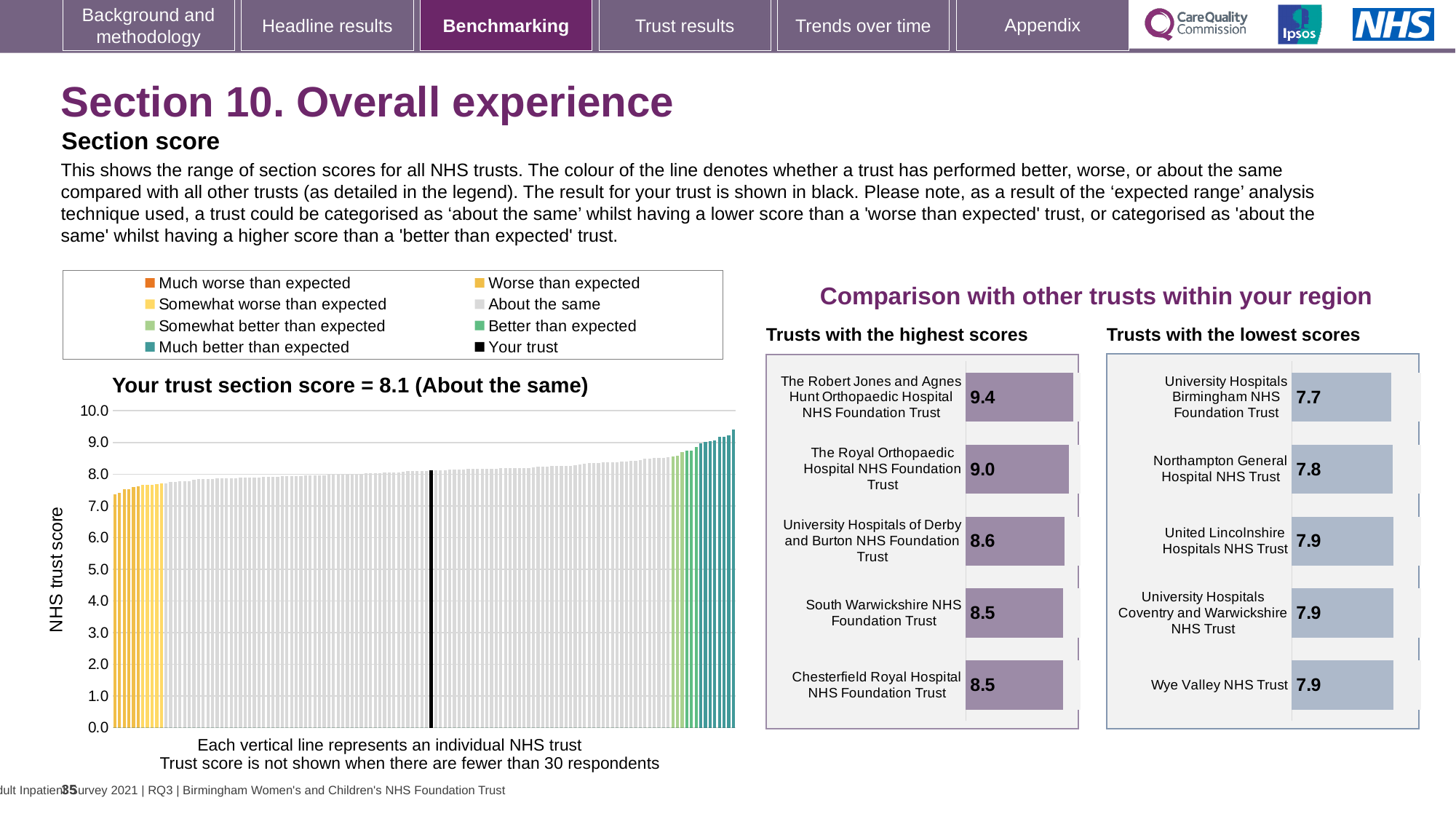
In the 'Trusts with the highest scores' chart, which has the higher score: The Royal Orthopaedic Hospital NHS Foundation Trust or Chesterfield Royal Hospital NHS Foundation Trust? The Royal Orthopaedic Hospital NHS Foundation Trust What kind of chart is the main chart on the left titled 'Your trust section score = 8.1 (About the same)'? Bar chart In the 'Trusts with the highest scores' chart, what is the difference between the scores of The Robert Jones and Agnes Hunt Orthopaedic Hospital NHS Foundation Trust and South Warwickshire NHS Foundation Trust? 0.9 According to the title of the main chart on the left, what is your trust's section score? 8.1 In the 'Trusts with the lowest scores' chart, what is the score for Northampton General Hospital NHS Trust? 7.8 How many trusts are listed in the 'Trusts with the lowest scores' chart? 5 In the 'Trusts with the highest scores' chart, what is the score for University Hospitals of Derby and Burton NHS Foundation Trust? 8.6 In the 'Trusts with the lowest scores' chart, what is the difference between the scores of Wye Valley NHS Trust and University Hospitals Birmingham NHS Foundation Trust? 0.2 In the 'Trusts with the highest scores' chart, which trust has the highest score? The Robert Jones and Agnes Hunt Orthopaedic Hospital NHS Foundation Trust In the main chart on the left, do the trust scores rise or fall from left to right along the x axis? Rise In the 'Trusts with the lowest scores' chart, which trust has the lowest score? University Hospitals Birmingham NHS Foundation Trust In the 'Trusts with the highest scores' chart, what is the score for The Robert Jones and Agnes Hunt Orthopaedic Hospital NHS Foundation Trust? 9.4